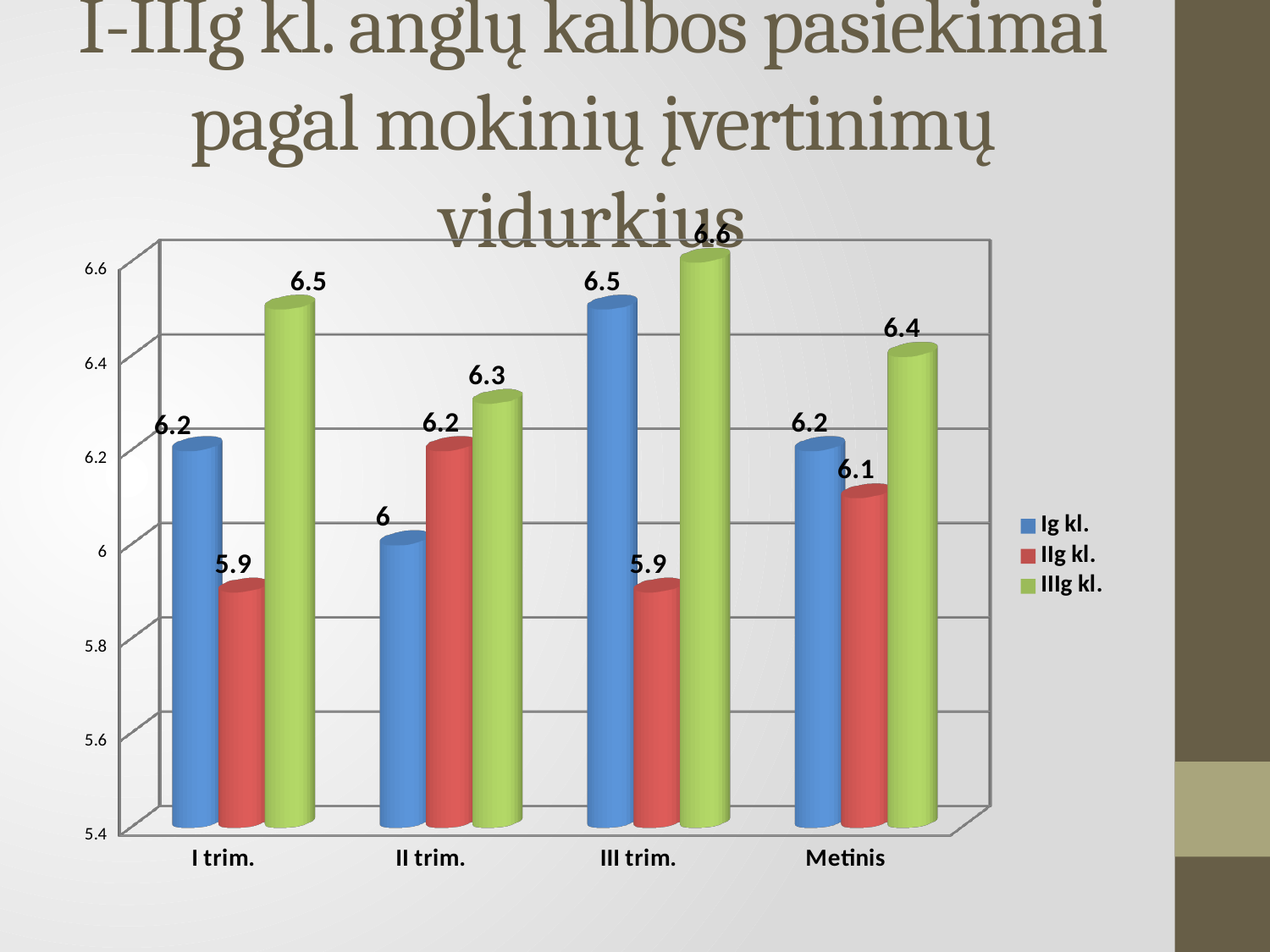
Which colour represents IIg kl. in the chart? red What is the value for Ig kl. in I trim.? 6.2 What is the difference between the IIIg kl. and IIg kl. values in III trim.? 0.7 How many series does the legend list? 3 How many categories are shown on the x axis? 4 What is the value for IIg kl. in III trim.? 5.9 What kind of chart is shown on the slide? bar chart What is the value for IIIg kl. in Metinis? 6.4 Which category has the lowest value for Ig kl.? II trim. Which is larger in II trim., the value for Ig kl. or IIg kl.? IIg kl. Which category has the highest value for IIIg kl.? III trim. What is the value for Ig kl. in II trim.? 6